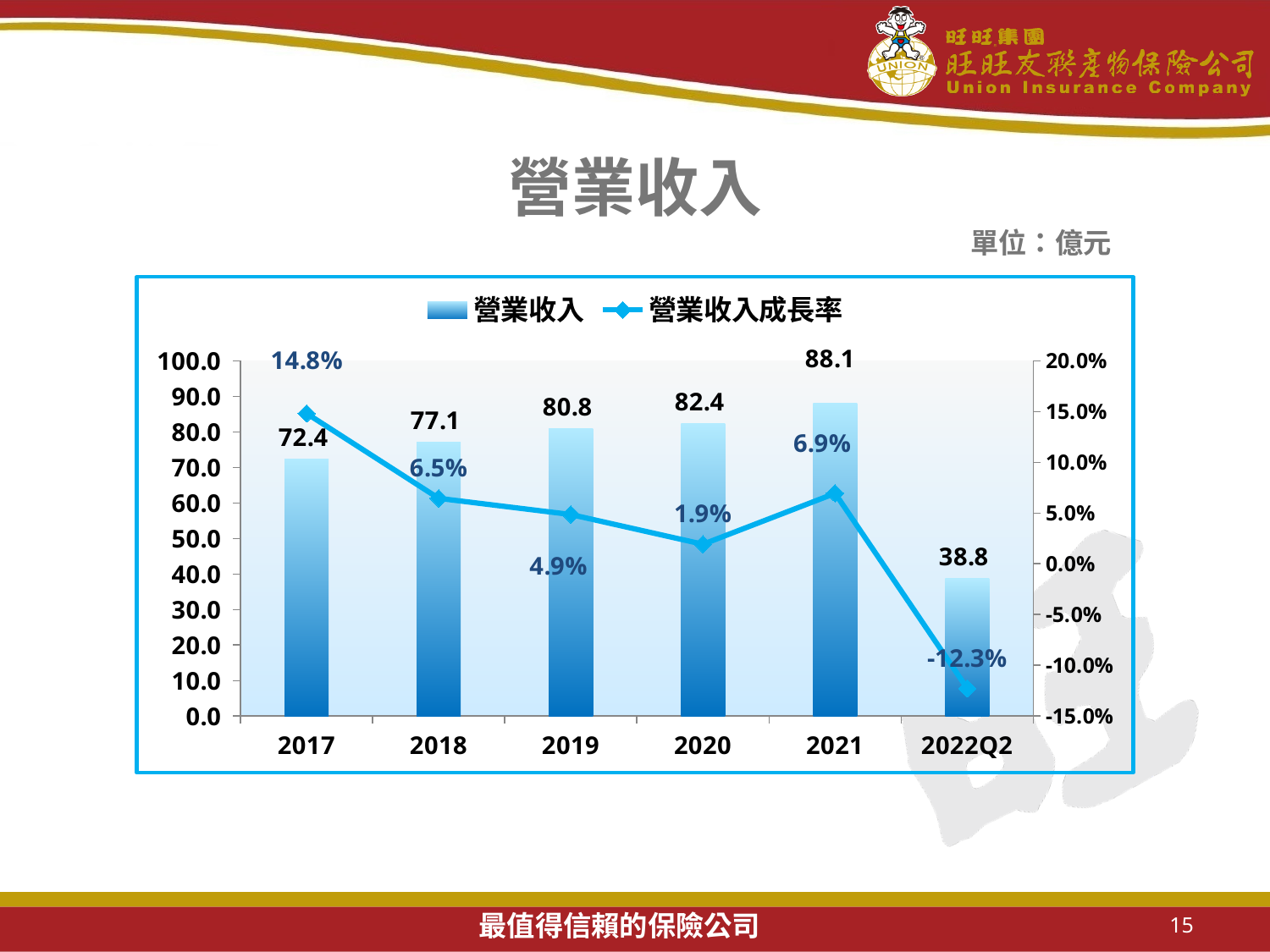
Which is larger, the 營業收入成長率 for 2017 or for 2021? 2017 What is the difference in 營業收入 between 2021 and 2020? 5.7 Is the 營業收入 value for 2018 greater or less than 70.0? greater How many categories are shown on the x axis? 6 Does the 營業收入 rise or fall from 2017 to 2021? rise What is the 營業收入成長率 for 2018? 6.5% What is the 營業收入 value for 2019? 80.8 Which year has the highest 營業收入? 2021 What is the title of the chart? 營業收入 How many series does the legend list? 2 What is the 營業收入 value for 2022Q2? 38.8 Which category has the lowest 營業收入成長率? 2022Q2